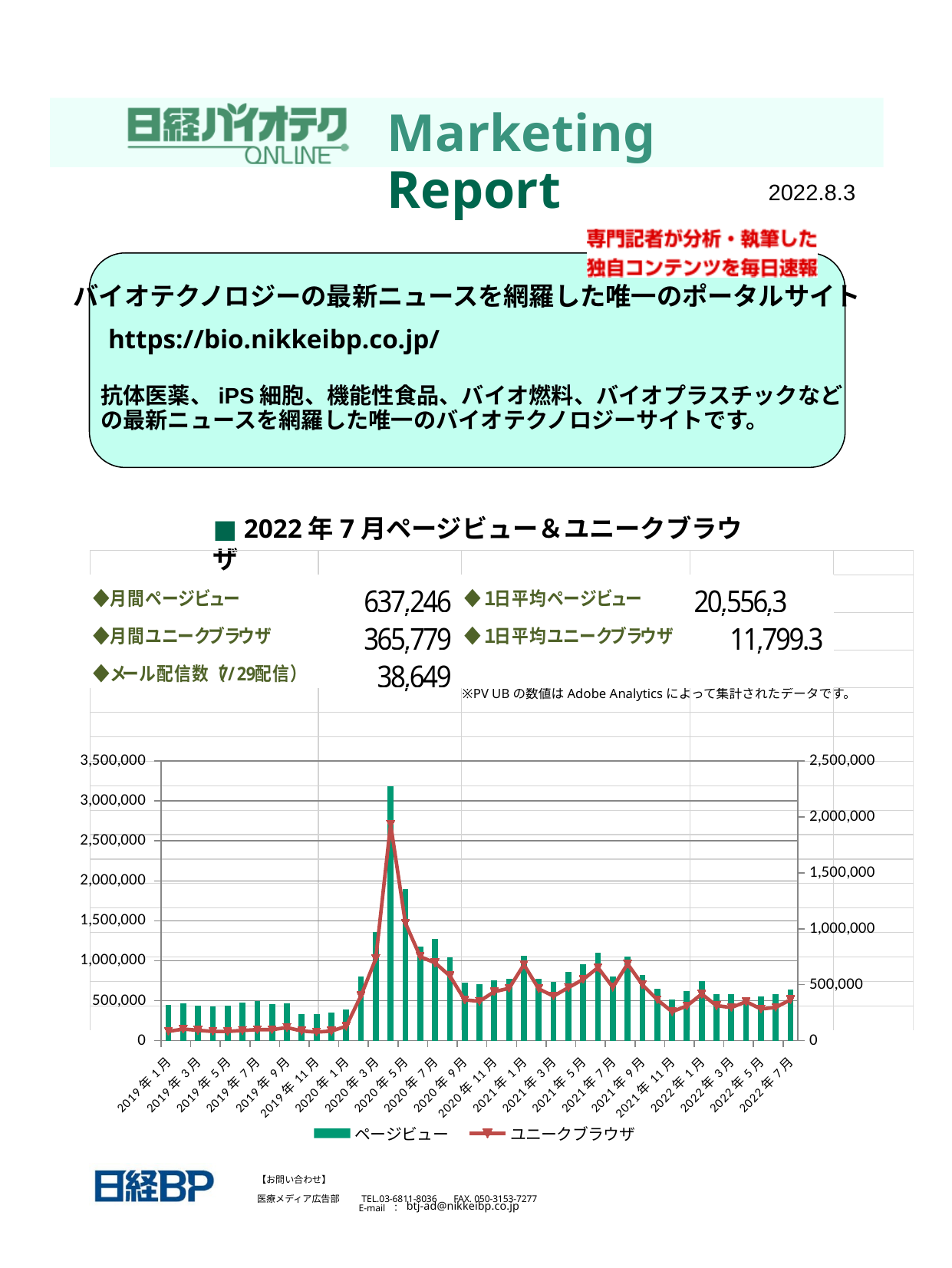
Which series is drawn as a line in the chart? ユニークブラウザ Do page views (ページビュー) rise or fall from 2019年11月 to 2020年3月? rise Is the page view (ページビュー) value for 2022年7月 greater or less than 500,000? greater Do page views (ページビュー) rise or fall from 2021年7月 to 2021年11月? fall Is the page view (ページビュー) value for 2019年11月 greater or less than 500,000? less Which series is drawn as bars in the chart? ページビュー In which year does the page view (ページビュー) peak occur? 2020 Is the peak of the unique browser (ユニークブラウザ) line greater or less than 1,500,000 on the right axis? greater How many series does the chart legend list? 2 What kind of chart is shown on the slide? Combined bar and line chart Which month has the larger page view (ページビュー) value, 2020年5月 or 2020年7月? 2020年5月